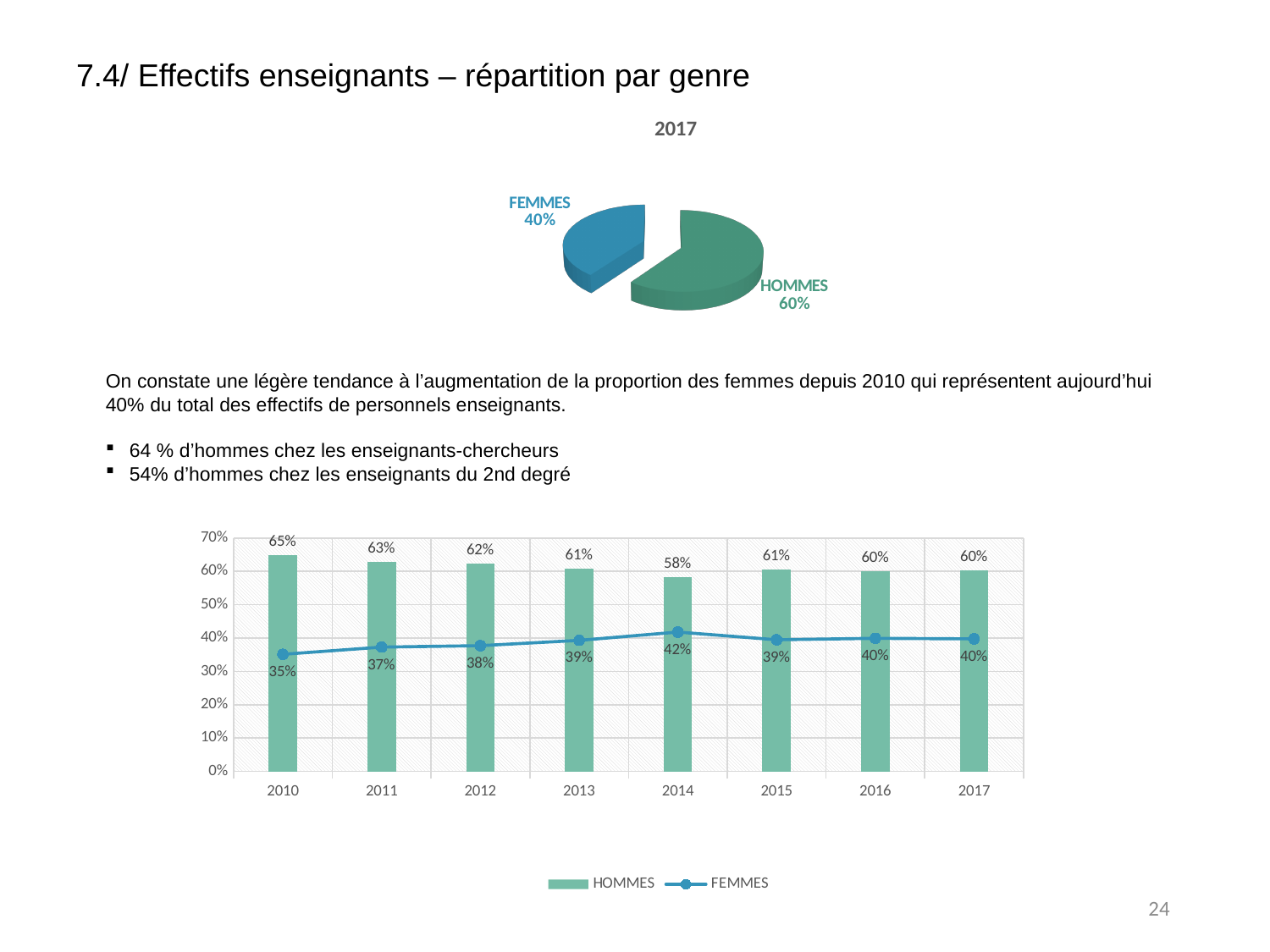
In the bottom chart, what is the value for FEMMES in 2014? 42% What kind of chart is the top chart titled 2017? pie chart In the bottom chart, how many series does the legend list? 2 In the bottom chart, which year has the highest value for FEMMES? 2014 In the bottom chart, which is larger in 2012: HOMMES or FEMMES? HOMMES In the bottom chart, how many years are shown on the x axis? 8 In the bottom chart, does the FEMMES value rise or fall from 2010 to 2014? rise In the pie chart titled 2017, what share is FEMMES? 40% In the bottom chart, what is the value for HOMMES in 2010? 65% In the bottom chart, which year has the lowest value for HOMMES? 2014 In the pie chart titled 2017, what share is HOMMES? 60% In the bottom chart, what is the difference between the HOMMES value in 2010 and in 2017? 5%